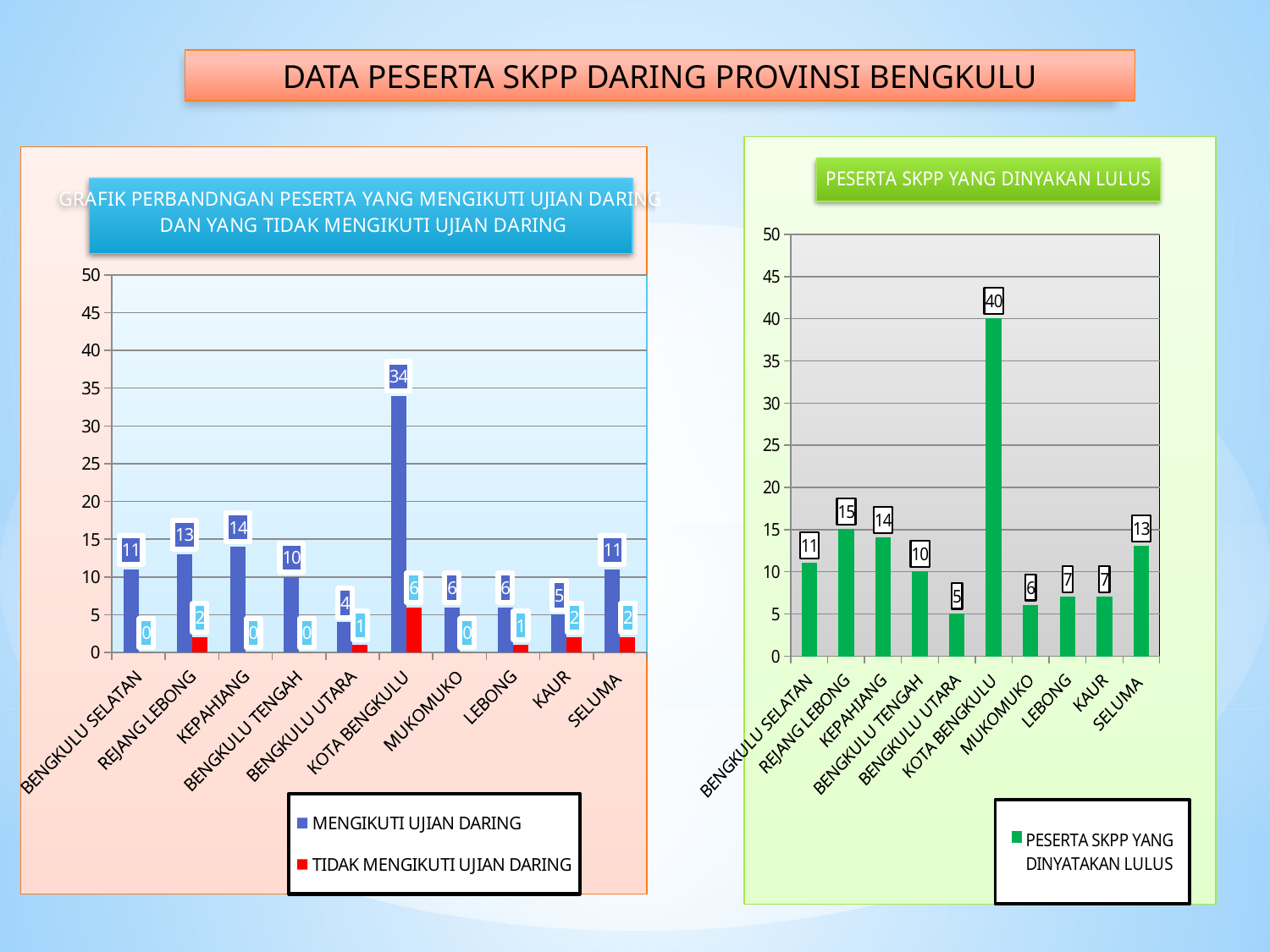
In the right chart (PESERTA SKPP YANG DINYAKAN LULUS), what is the value for KOTA BENGKULU? 40 In the left chart (GRAFIK PERBANDNGAN PESERTA...), which category has the highest MENGIKUTI UJIAN DARING value? KOTA BENGKULU In the right chart (PESERTA SKPP YANG DINYAKAN LULUS), which category has the lowest value? BENGKULU UTARA In the left chart (GRAFIK PERBANDNGAN PESERTA...), what is the difference between the MENGIKUTI UJIAN DARING and TIDAK MENGIKUTI UJIAN DARING values for KOTA BENGKULU? 28 In the right chart (PESERTA SKPP YANG DINYAKAN LULUS), which is larger, the value for REJANG LEBONG or the value for KEPAHIANG? REJANG LEBONG In the right chart (PESERTA SKPP YANG DINYAKAN LULUS), what is the value for SELUMA? 13 In the right chart (PESERTA SKPP YANG DINYAKAN LULUS), how many categories are shown on the x axis? 10 In the left chart (GRAFIK PERBANDNGAN PESERTA...), what is the MENGIKUTI UJIAN DARING value for KOTA BENGKULU? 34 In the left chart (GRAFIK PERBANDNGAN PESERTA...), how many series does the legend list? 2 In the left chart (GRAFIK PERBANDNGAN PESERTA...), what is the TIDAK MENGIKUTI UJIAN DARING value for REJANG LEBONG? 2 In the left chart (GRAFIK PERBANDNGAN PESERTA...), which category has the lowest MENGIKUTI UJIAN DARING value? BENGKULU UTARA What kind of chart is the right chart (PESERTA SKPP YANG DINYAKAN LULUS)? Bar chart